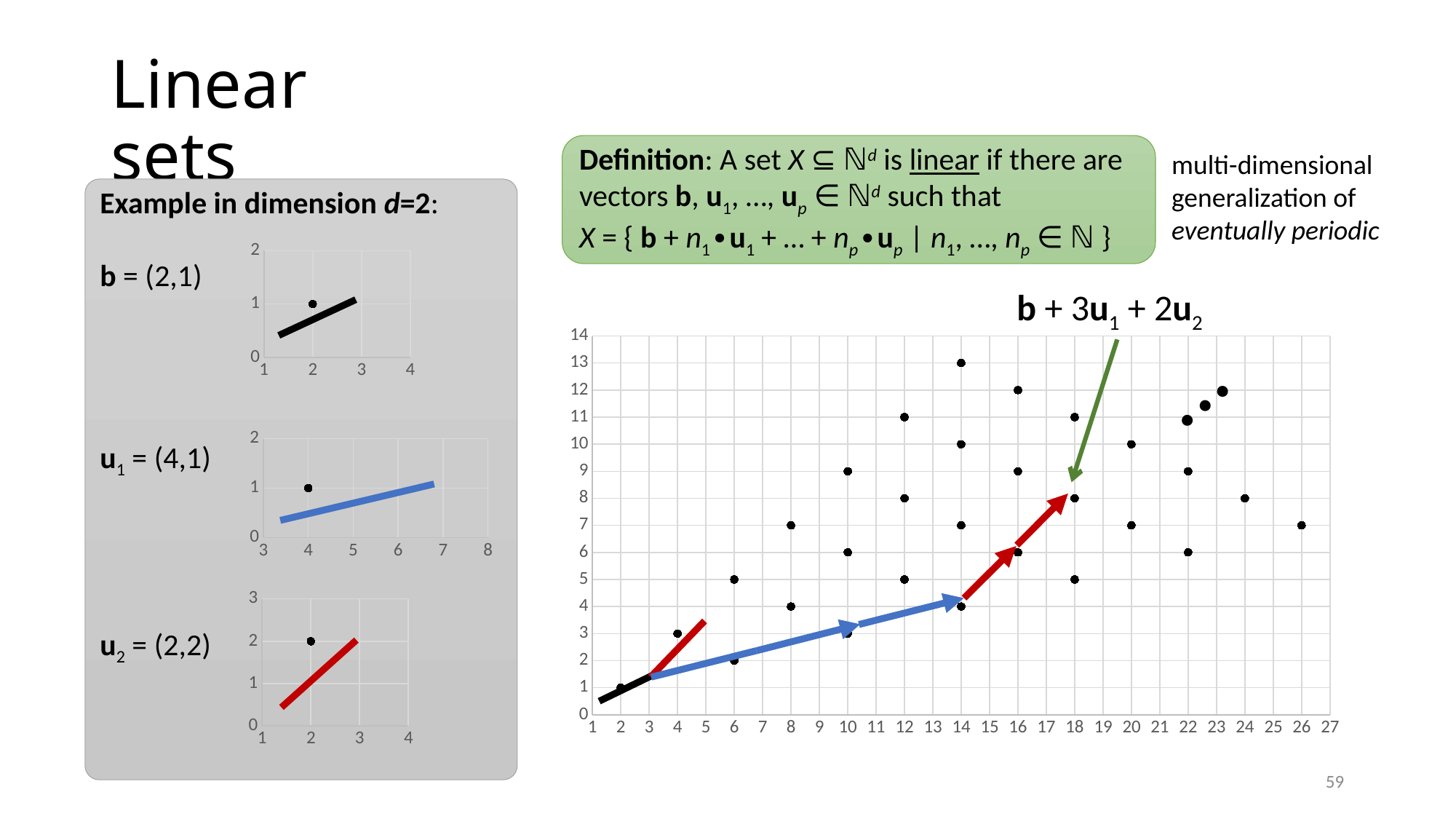
In the large chart on the right, at which x value does the point with the highest y value (13) lie? 14 How many plotted points does the small chart labelled u2 = (2,2) contain? 1 In the large chart on the right, what is the highest y value reached by any plotted point? 13 In the large chart on the right, what is the y value of the leftmost plotted point (at x = 2)? 1 In the small chart labelled b = (2,1) on the left, what are the x and y coordinates of the plotted point? (2,1) In the large chart on the right, what is the largest value shown on the y axis? 14 In the large chart on the right, what is the y value of the rightmost plotted point (at x = 26)? 7 In the large chart on the right, what is the largest value shown on the x axis? 27 In the small chart labelled u2 = (2,2) on the left, what is the y value of the plotted point? 2 In the large chart on the right, is the y value of the point at x = 4 greater or less than 2? greater In the small chart labelled u1 = (4,1) on the left, what is the x value of the plotted point? 4 What kind of chart is the large chart on the right of the slide? scatter chart